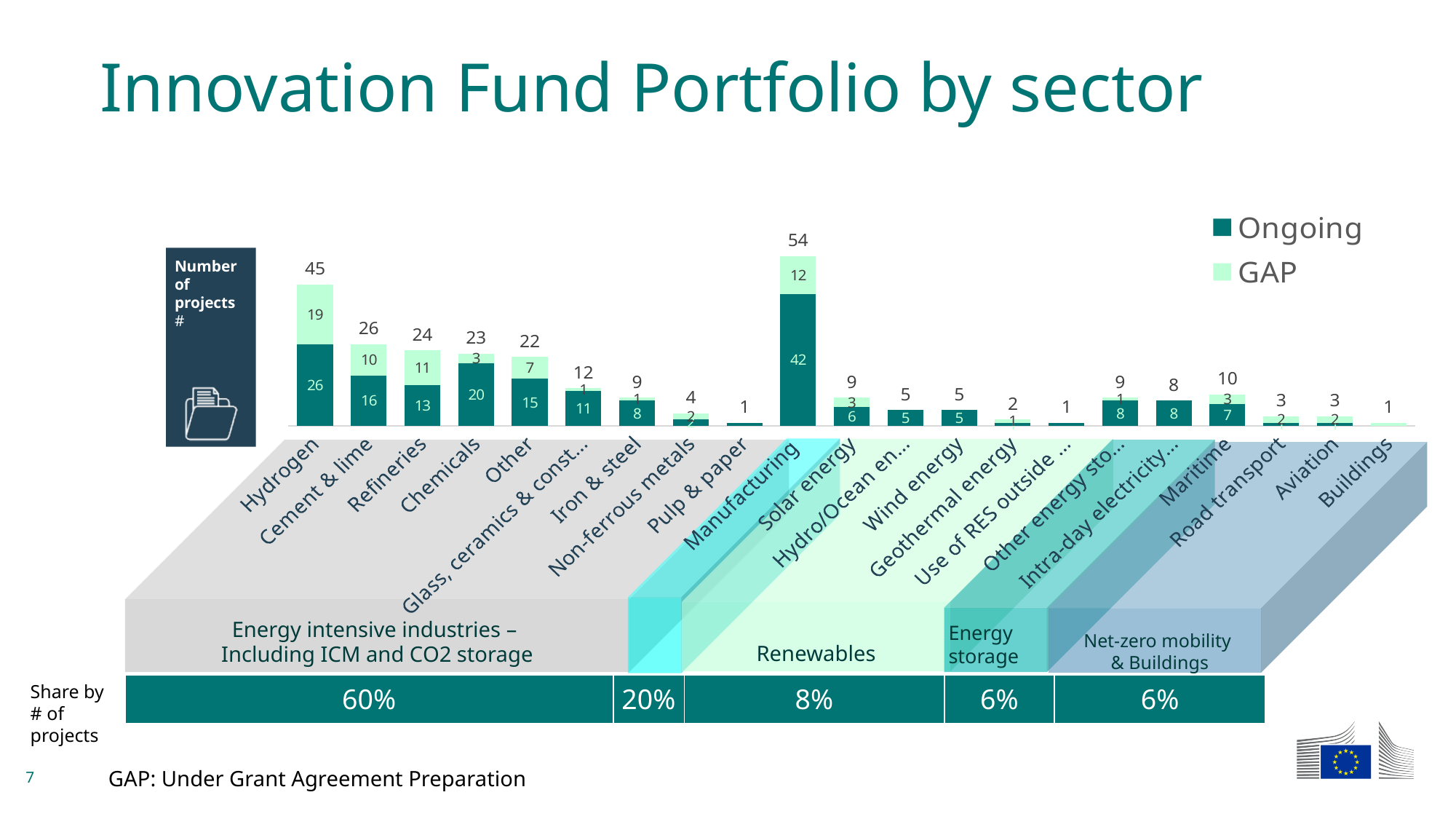
What share of projects by number does the Energy intensive industries group account for? 60% What is the total number of projects for Solar energy? 9 How many series does the legend list? 2 Which has more total projects, Refineries or Chemicals? Refineries What does GAP stand for according to the slide? Under Grant Agreement Preparation What type of chart is shown on the slide? Stacked bar chart What is the total number of projects for Hydrogen? 45 Which sector has the highest total number of projects? Manufacturing How many GAP projects are there for Cement & lime? 10 How many Ongoing projects are there for Maritime? 7 What is the difference between the total number of projects for Manufacturing and Hydrogen? 9 How many Ongoing projects are there for Manufacturing? 42